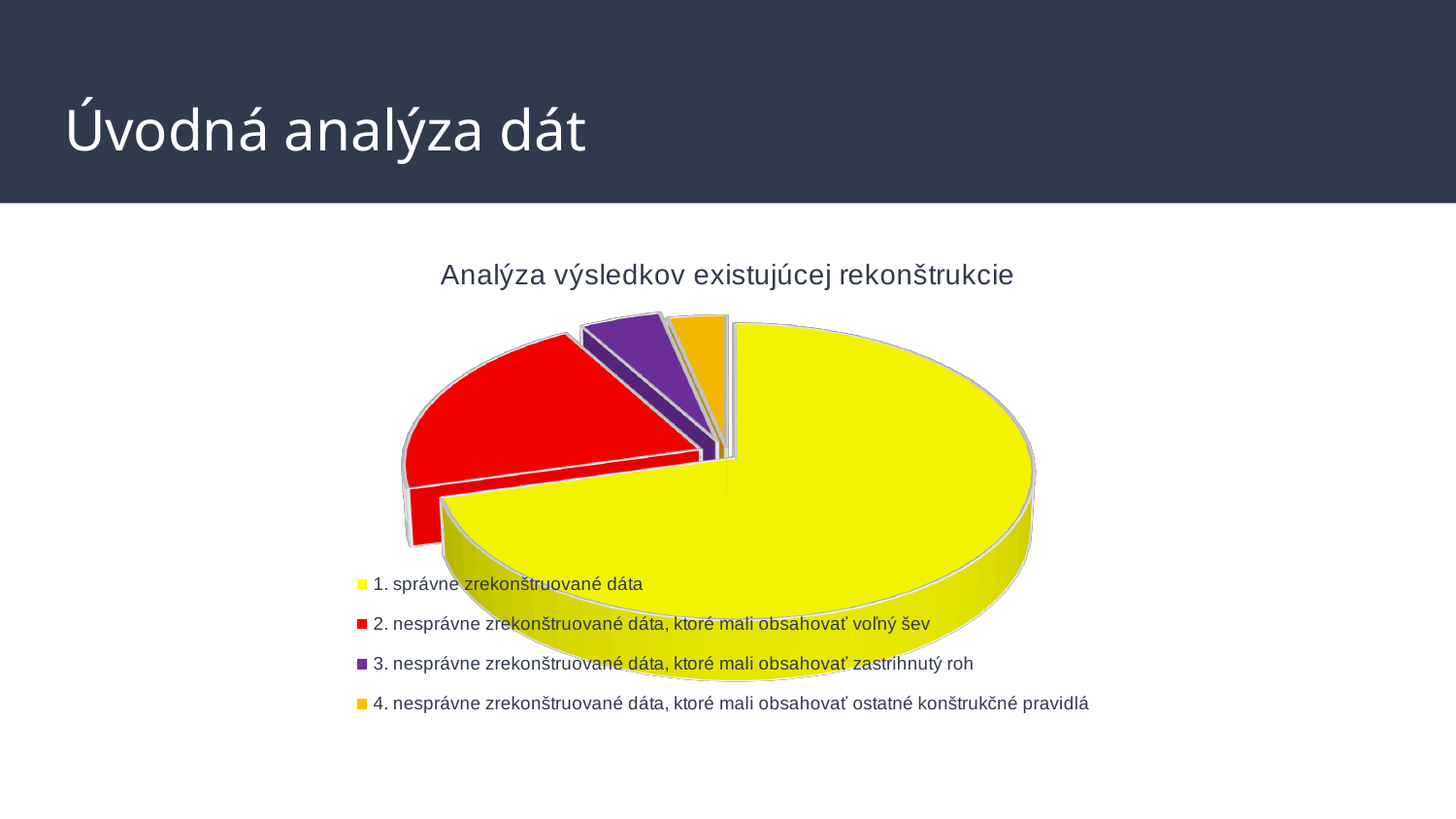
What kind of chart is shown on the slide? pie chart Which slice is larger: '4. nesprávne zrekonštruované dáta, ktoré mali obsahovať ostatné konštrukčné pravidlá' or '2. nesprávne zrekonštruované dáta, ktoré mali obsahovať voľný šev'? 2. nesprávne zrekonštruované dáta, ktoré mali obsahovať voľný šev Which category has the largest slice of the pie? 1. správne zrekonštruované dáta Which slice is larger: '1. správne zrekonštruované dáta' or '2. nesprávne zrekonštruované dáta, ktoré mali obsahovať voľný šev'? 1. správne zrekonštruované dáta Which slice is larger: '2. nesprávne zrekonštruované dáta, ktoré mali obsahovať voľný šev' or '3. nesprávne zrekonštruované dáta, ktoré mali obsahovať zastrihnutý roh'? 2. nesprávne zrekonštruované dáta, ktoré mali obsahovať voľný šev Does the largest slice of the pie represent more or less than half of the total? more How many categories does the pie chart have? 4 What is the title of the chart? Analýza výsledkov existujúcej rekonštrukcie What colour represents '1. správne zrekonštruované dáta' in the pie chart? yellow